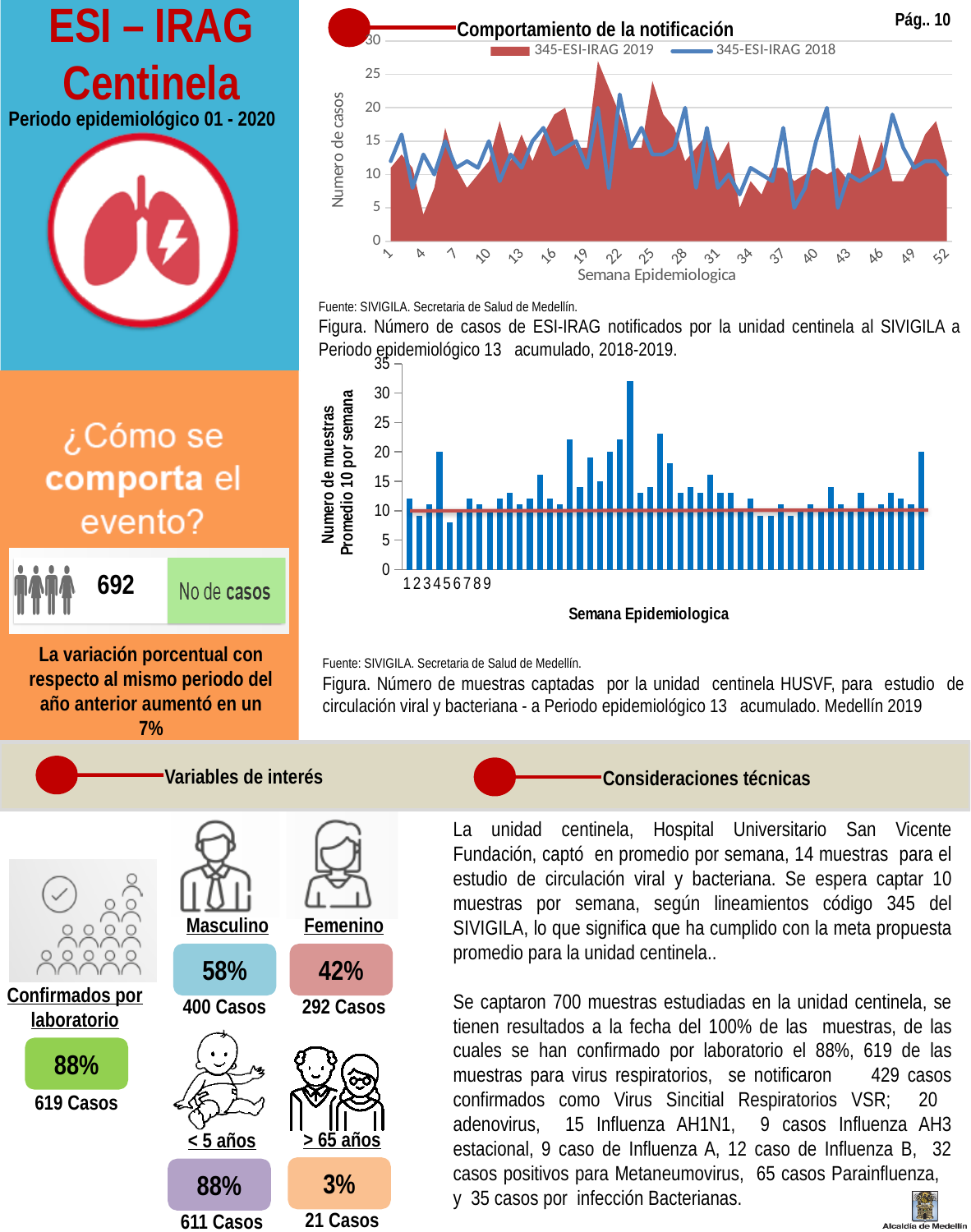
What kind of chart is the bottom chart (Numero de muestras)? bar chart In the bottom chart (Numero de muestras), at what value on the y axis is the red horizontal reference line drawn? 10 In the bottom chart (Numero de muestras), is the tallest bar greater or less than 30? greater In the bottom chart (Numero de muestras), is the value for week 4 greater or less than 15? greater In the top chart 'Comportamiento de la notificación', is the peak value of the 345-ESI-IRAG 2019 series greater or less than 20? greater In the top chart 'Comportamiento de la notificación', what are the two series named in the legend? 345-ESI-IRAG 2019 and 345-ESI-IRAG 2018 What is the y-axis title of the top chart 'Comportamiento de la notificación'? Numero de casos In the bottom chart (Numero de muestras), which of weeks 4 and 5 has the larger value? week 4 How many series does the legend of the top chart 'Comportamiento de la notificación' list? 2 In the top chart 'Comportamiento de la notificación', up to which epidemiological week does the x axis extend? 52